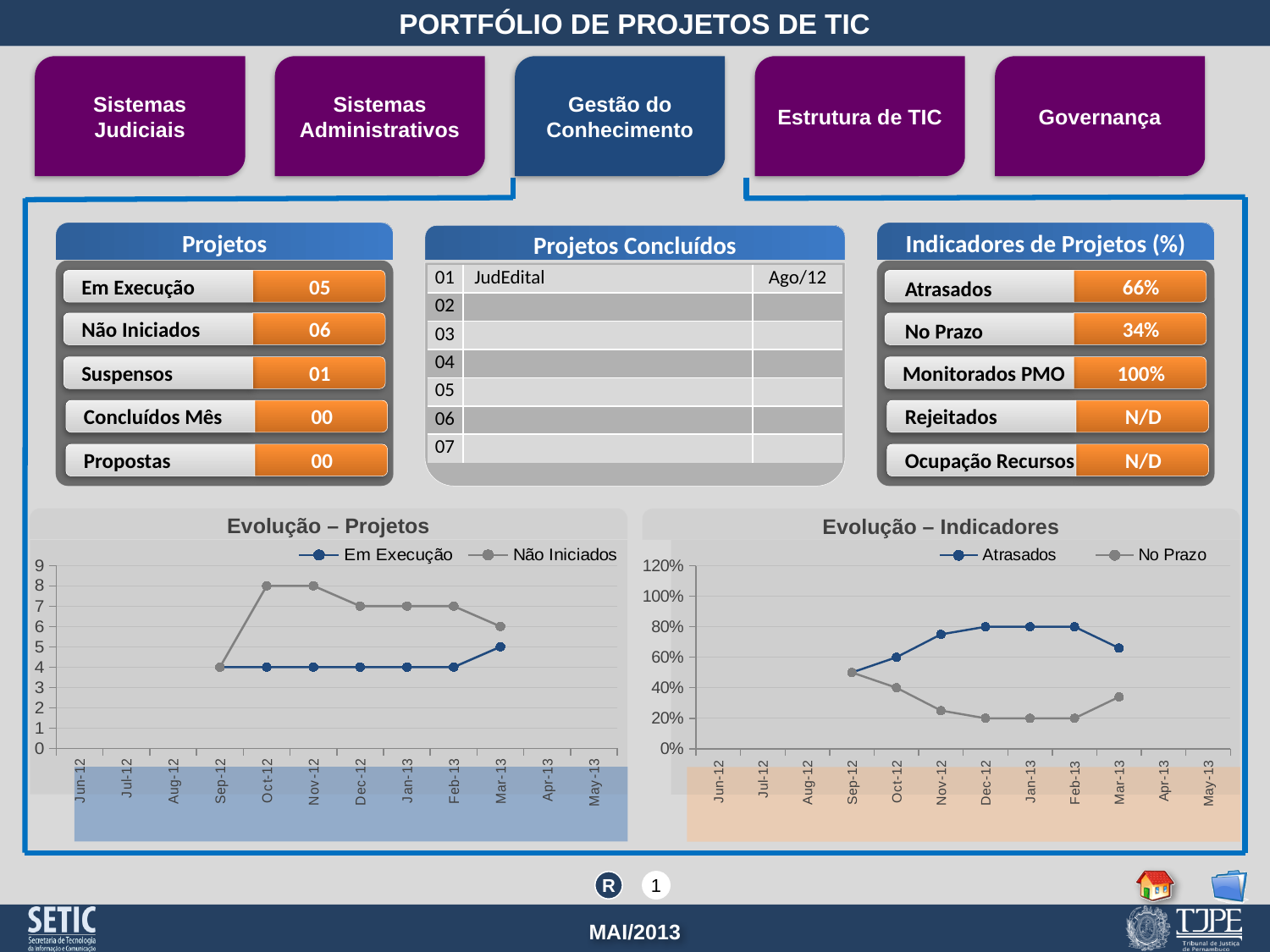
In the "Evolução – Projetos" chart, what is the difference between Não Iniciados and Em Execução in Oct-12? 4 In the "Evolução – Projetos" chart, how many months have plotted data points? 7 In the "Evolução – Projetos" chart, what is the value of Não Iniciados in Oct-12? 8 How many series does the legend of the "Evolução – Projetos" chart list? 2 In the "Evolução – Indicadores" chart, is the value for Atrasados in Nov-12 greater or less than 60%? greater In the "Evolução – Projetos" chart, does Em Execução rise or fall from Feb-13 to Mar-13? rises In the "Evolução – Projetos" chart, what is the value of Em Execução in Mar-13? 5 In the "Evolução – Indicadores" chart, which series is higher in Jan-13, Atrasados or No Prazo? Atrasados In the "Evolução – Indicadores" chart, what is the value of Atrasados in Dec-12? 80% In the "Evolução – Projetos" chart, in which month is Não Iniciados lowest? Sep-12 In the "Evolução – Indicadores" chart, what is the value of No Prazo in Oct-12? 40% What kind of chart is the "Evolução – Projetos" chart? line chart